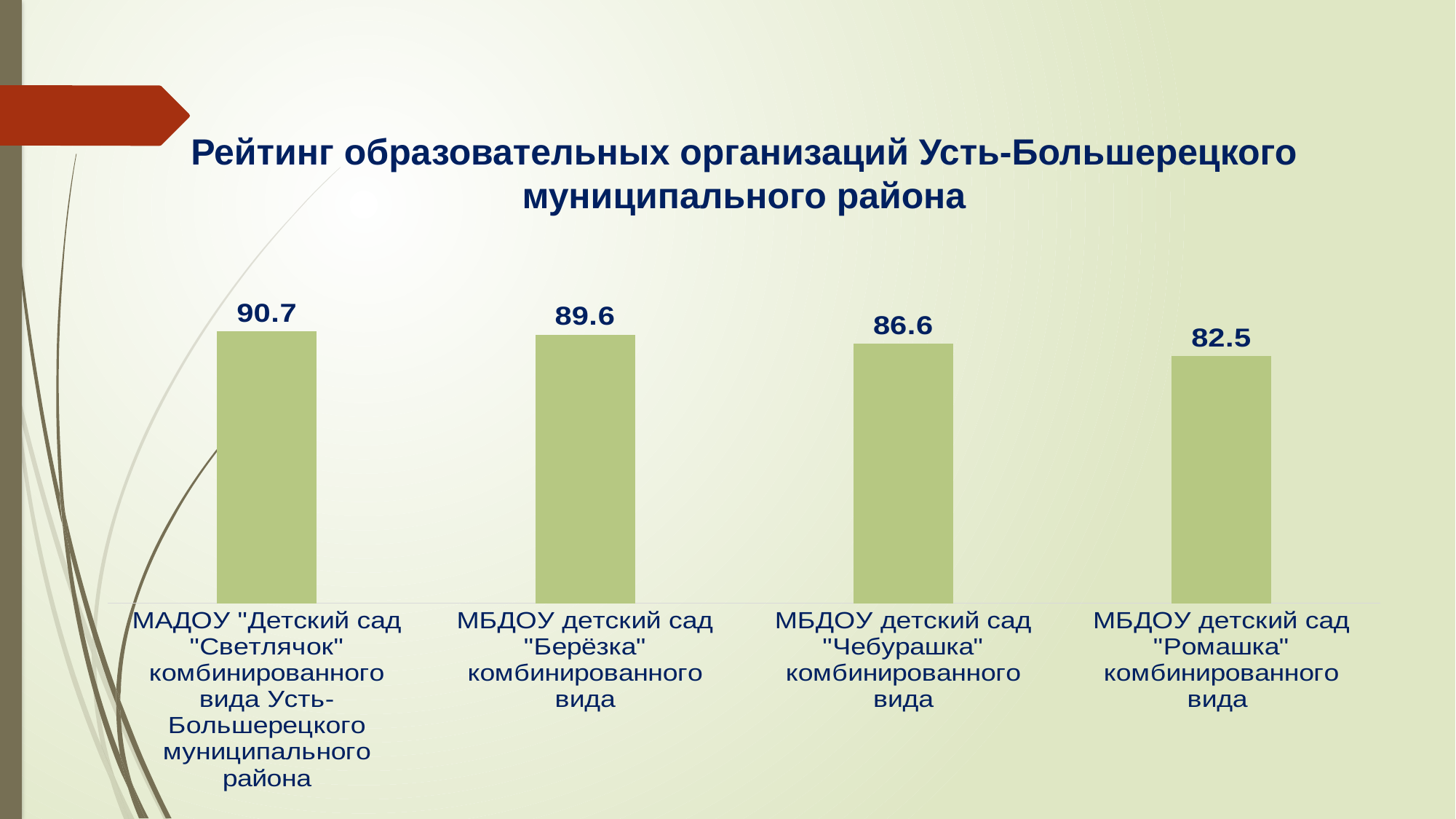
What is the value for МБДОУ детский сад "Берёзка"? 89.6 What is the difference between the values for "Берёзка" and "Чебурашка"? 3 Which has a larger value, "Чебурашка" or "Ромашка"? МБДОУ детский сад "Чебурашка" What kind of chart is shown on the slide? Bar chart Which organisation has the lowest rating? МБДОУ детский сад "Ромашка" How many organisations are shown in the chart? 4 What is the value for МБДОУ детский сад "Чебурашка"? 86.6 Do the values rise or fall from left to right along the x axis? Fall Which organisation has the highest rating? МАДОУ "Детский сад "Светлячок" What is the value for МБДОУ детский сад "Ромашка"? 82.5 What is the value for МАДОУ "Детский сад "Светлячок"? 90.7 What is the difference between the values for "Светлячок" and "Ромашка"? 8.2